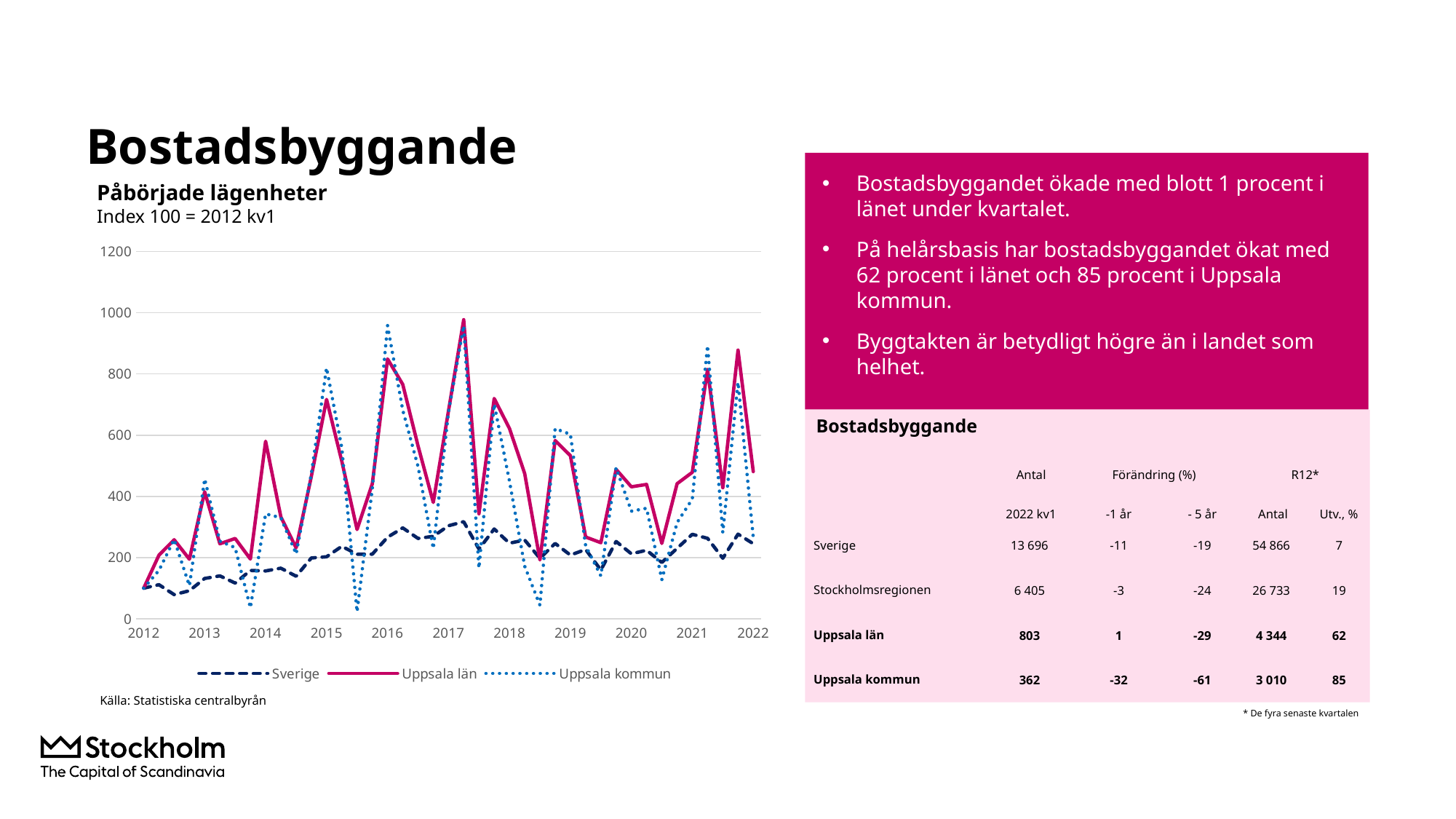
Which series are listed in the legend of the 'Påbörjade lägenheter' chart? Sverige, Uppsala län, Uppsala kommun In the 'Påbörjade lägenheter' chart, is the highest value reached by the Uppsala kommun series greater or less than 800? greater In the 'Påbörjade lägenheter' chart, at the 2017 peak, which is larger: Uppsala län or Sverige? Uppsala län In the 'Påbörjade lägenheter' chart, is the highest value reached by the Sverige series greater or less than 400? less In the 'Påbörjade lägenheter' chart, does the Sverige series overall rise or fall from 2012 to 2022? rise How many year labels are shown on the x axis of the 'Påbörjade lägenheter' chart? 11 In the 'Påbörjade lägenheter' chart, is the highest value reached by the Uppsala län series greater or less than 800? greater In the 'Påbörjade lägenheter' chart, which series stays lowest for most of the period? Sverige How many series does the legend of the 'Påbörjade lägenheter' chart list? 3 What kind of chart is shown under the heading 'Påbörjade lägenheter'? line chart What is the index base stated under the chart title 'Påbörjade lägenheter'? Index 100 = 2012 kv1